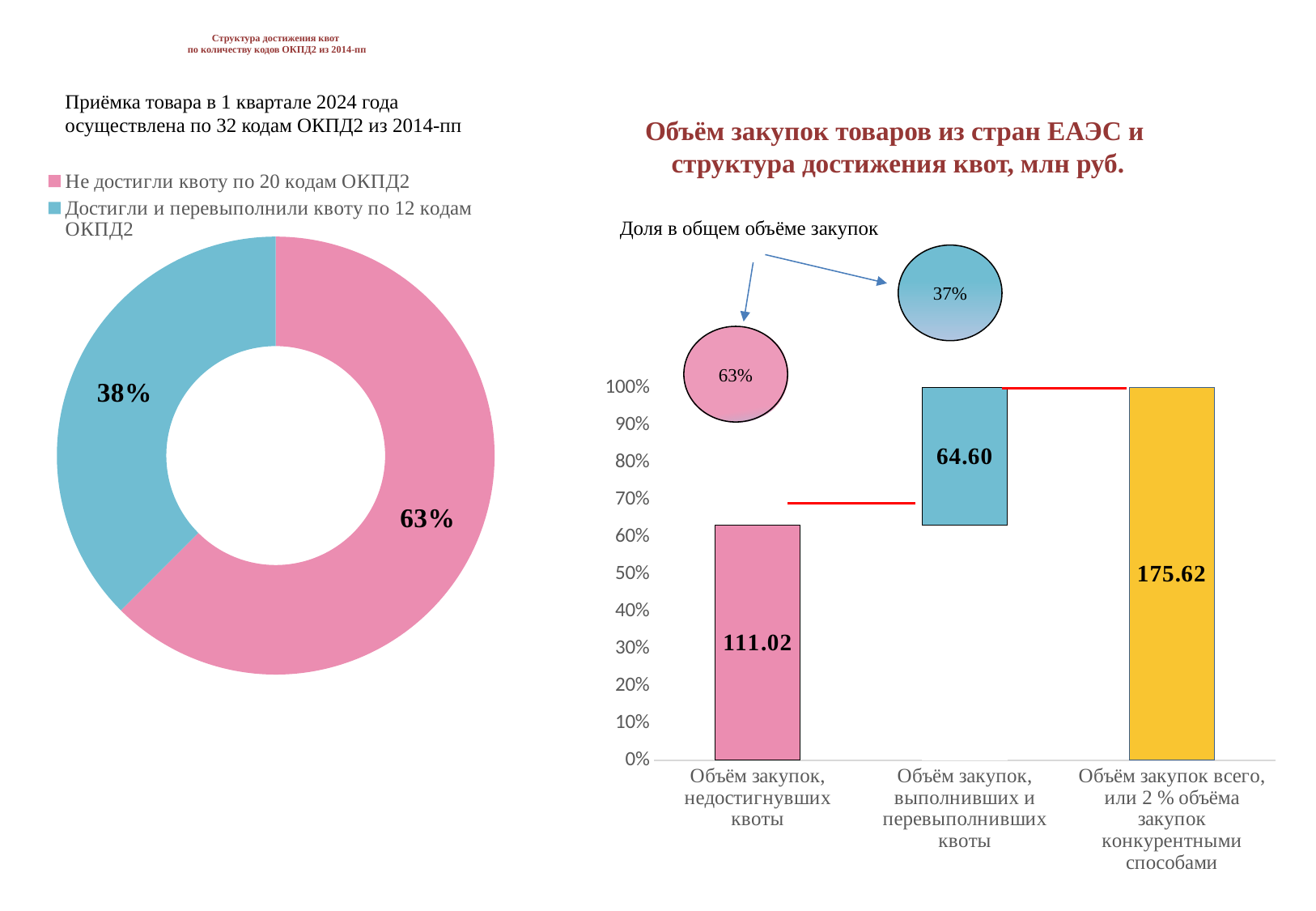
How many bars are plotted on the right chart 'Объём закупок товаров из стран ЕАЭС и структура достижения квот, млн руб.'? 3 On the right chart, which bar has the lowest value? Объём закупок, выполнивших и перевыполнивших квоты On the left donut chart, what share is shown for the segment 'Достигли и перевыполнили квоту по 12 кодам ОКПД2'? 38% On the left donut chart, which segment is larger? Не достигли квоту по 20 кодам ОКПД2 What kind of chart is shown on the left side of the slide? Donut (pie) chart On the right chart 'Объём закупок товаров из стран ЕАЭС и структура достижения квот, млн руб.', what is the value for 'Объём закупок, недостигнувших квоты'? 111.02 On the right chart, what share in the total purchase volume is shown in the circle above the 'Объём закупок, выполнивших и перевыполнивших квоты' bar? 37% On the right chart 'Объём закупок товаров из стран ЕАЭС и структура достижения квот, млн руб.', what is the value for 'Объём закупок всего, или 2 % объёма закупок конкурентными способами'? 175.62 How many entries does the legend of the left donut chart list? 2 On the right chart 'Объём закупок товаров из стран ЕАЭС и структура достижения квот, млн руб.', what is the value for 'Объём закупок, выполнивших и перевыполнивших квоты'? 64.60 On the right chart, what is the difference between the value for 'Объём закупок, недостигнувших квоты' and the value for 'Объём закупок, выполнивших и перевыполнивших квоты'? 46.42 On the left donut chart, what share is shown for the segment 'Не достигли квоту по 20 кодам ОКПД2'? 63%